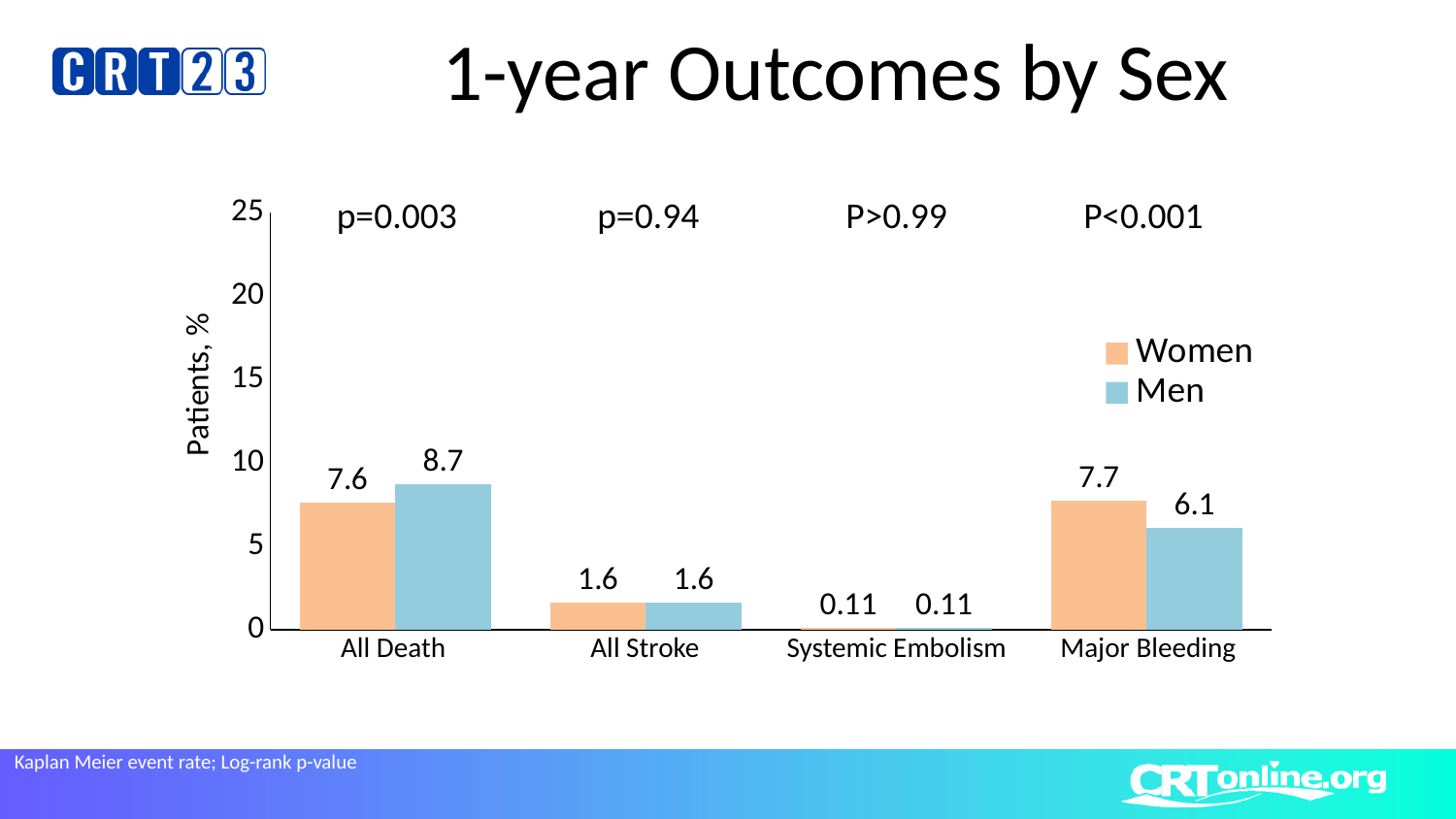
What is the label of the y axis? Patients, % What is the value for Women in the All Death category? 7.6 What kind of chart is shown on the slide? Bar chart What is the value for Women in the Systemic Embolism category? 0.11 Which category has the lowest value for Women? Systemic Embolism How many series does the legend list? 2 What is the value for Men in the Major Bleeding category? 6.1 Which is larger for Major Bleeding, the value for Women or the value for Men? Women How many categories are shown on the x axis? 4 What is the difference between the Men and Women values for All Death? 1.1 What is the value for Men in the All Stroke category? 1.6 Which category has the highest value for Men? All Death